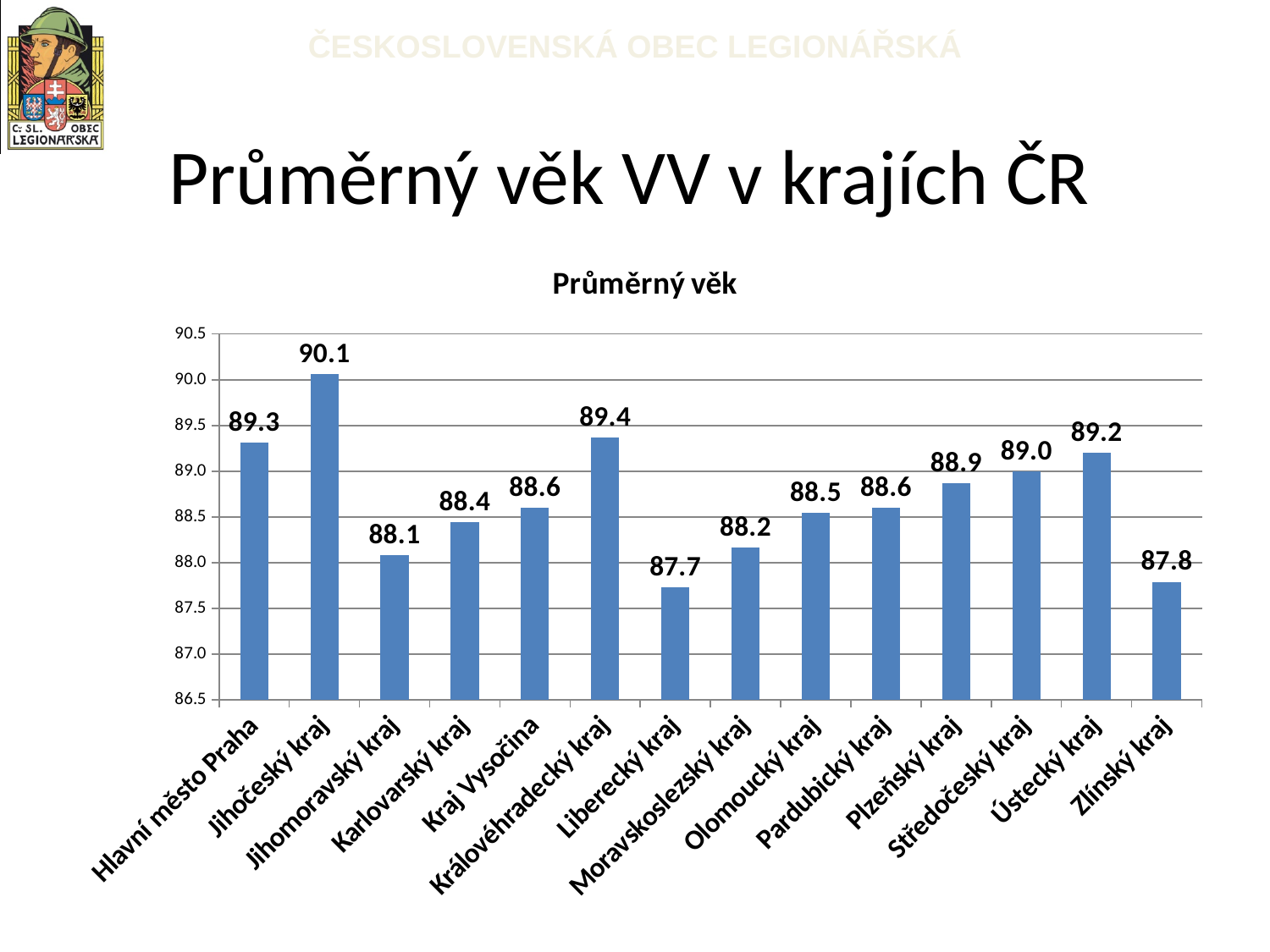
What is the difference between the values for Jihočeský kraj and Liberecký kraj? 2.4 What is the title of the chart? Průměrný věk What kind of chart is shown on the slide? bar chart Is the value for Zlínský kraj greater or less than 88.0? less What is the value for Středočeský kraj? 89.0 How many regions are shown on the x axis? 14 Which region has the lowest average age? Liberecký kraj What is the average age shown for Jihočeský kraj? 90.1 Which is larger, the value for Královéhradecký kraj or for Hlavní město Praha? Královéhradecký kraj What is the difference between the values for Jihočeský kraj and Jihomoravský kraj? 2.0 What value is shown for Liberecký kraj? 87.7 Which region has the highest average age? Jihočeský kraj